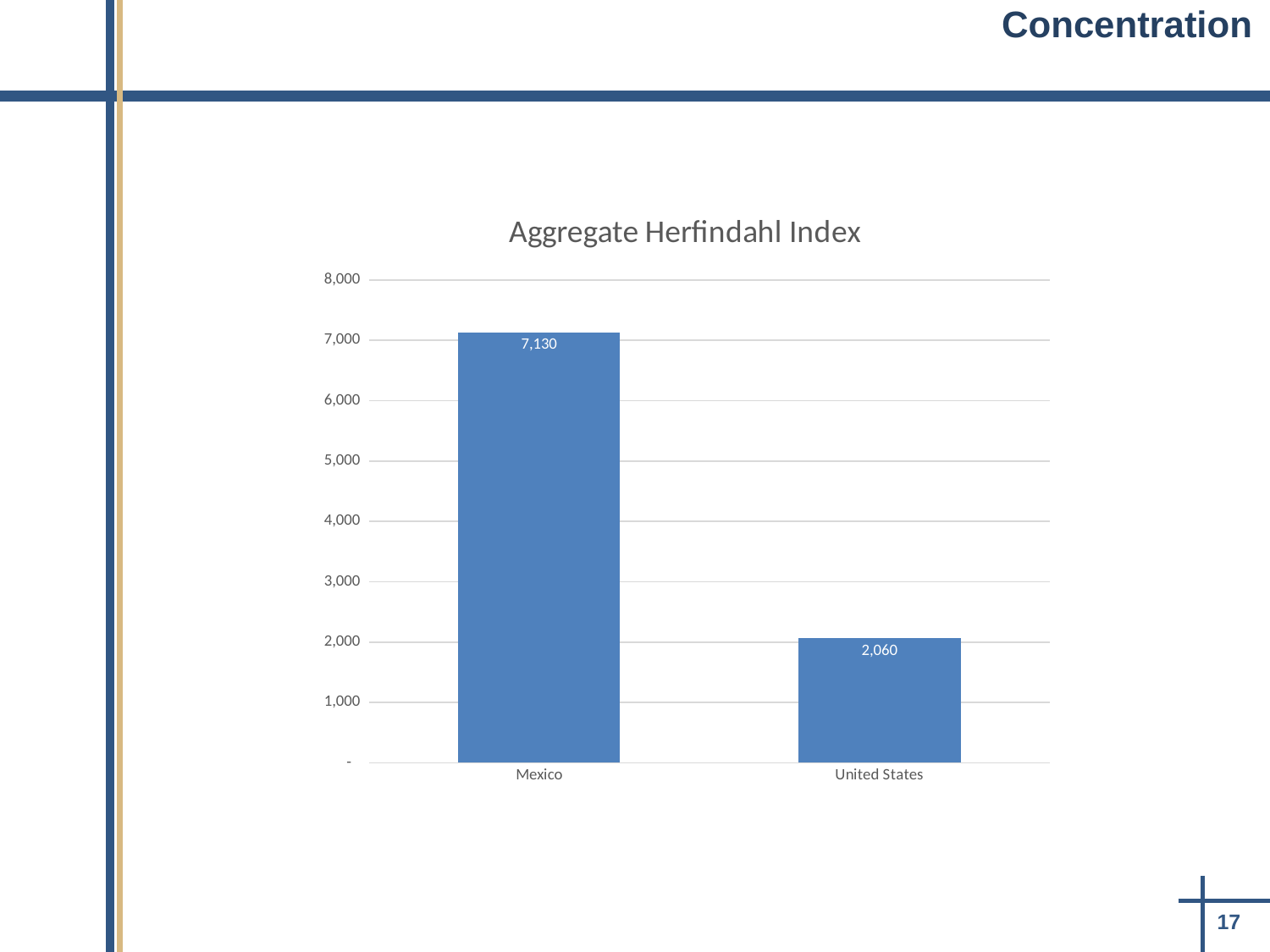
Is the value for the United States greater or less than 3,000? less What is the Aggregate Herfindahl Index value for the United States? 2,060 Is the value for Mexico greater or less than 6,000? greater How many countries are shown in the chart? 2 Which country has the highest Aggregate Herfindahl Index? Mexico What kind of chart is shown on the slide? bar chart Which country has the lowest Aggregate Herfindahl Index? United States What is the difference between the Aggregate Herfindahl Index for Mexico and the United States? 5,070 What is the title of the chart? Aggregate Herfindahl Index What is the highest value shown on the vertical axis of the chart? 8,000 What is the Aggregate Herfindahl Index value for Mexico? 7,130 Which is larger, the Aggregate Herfindahl Index for Mexico or for the United States? Mexico